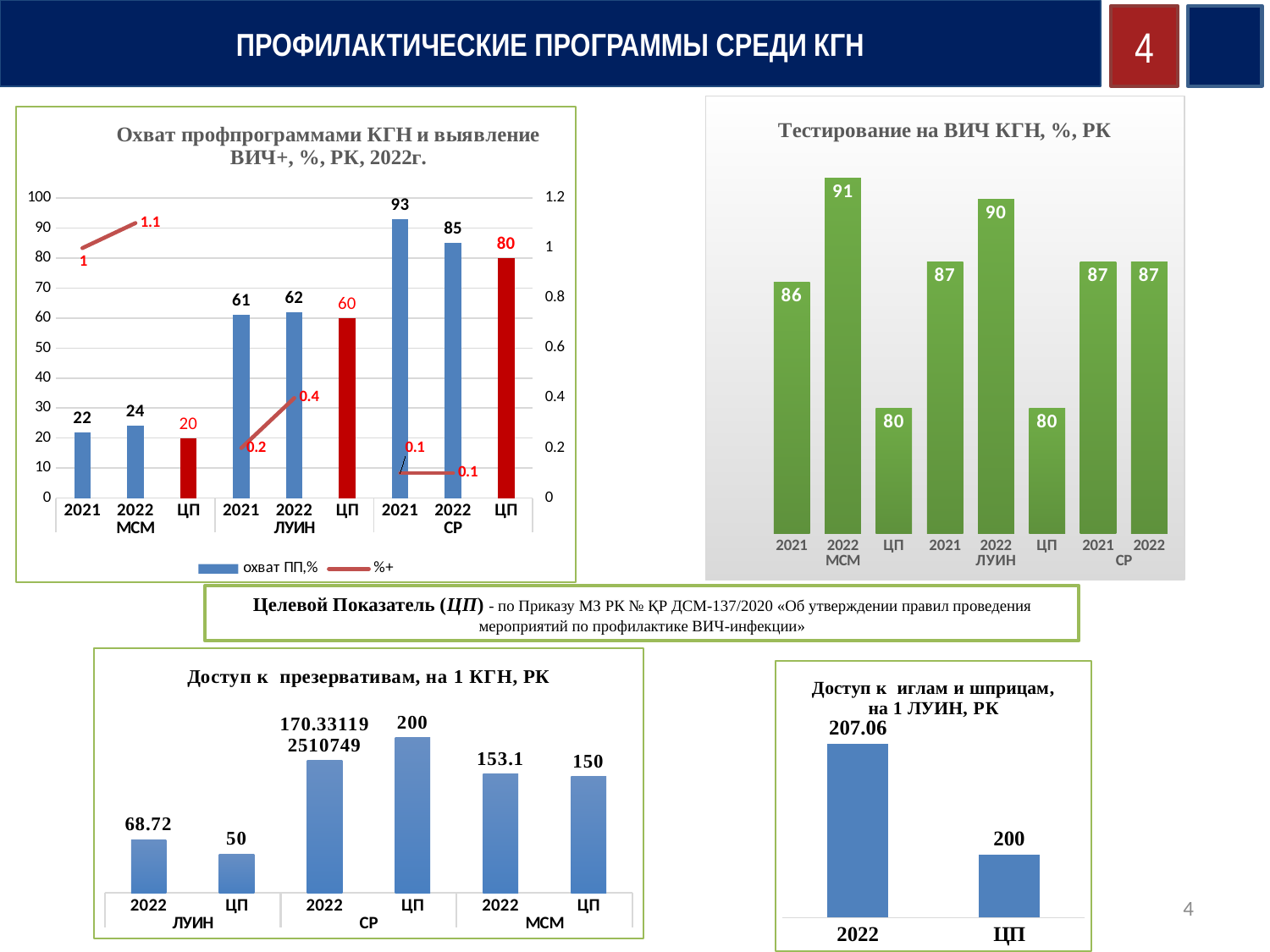
In the chart 'Тестирование на ВИЧ КГН, %, РК', which bar has the highest value? МСМ 2022 In the chart 'Доступ к иглам и шприцам, на 1 ЛУИН, РК', what is the value for 2022? 207.06 In the chart 'Тестирование на ВИЧ КГН, %, РК', what is the difference between ЛУИН 2022 and the ЛУИН ЦП value? 10 In the chart 'Охват профпрограммами КГН и выявление ВИЧ+, %, РК, 2022г.', what is the охват ПП,% value for СР in 2021? 93 How many series does the legend list in the chart 'Охват профпрограммами КГН и выявление ВИЧ+, %, РК, 2022г.'? 2 In the chart 'Охват профпрограммами КГН и выявление ВИЧ+, %, РК, 2022г.', which is larger: the охват ПП,% value for ЛУИН in 2022 or the ЦП value for ЛУИН? ЛУИН 2022 What kind of chart is 'Тестирование на ВИЧ КГН, %, РК'? Bar chart In the chart 'Тестирование на ВИЧ КГН, %, РК', what is the value for МСМ in 2022? 91 In the chart 'Охват профпрограммами КГН и выявление ВИЧ+, %, РК, 2022г.', what is the %+ value for МСМ in 2022? 1.1 In the chart 'Доступ к презервативам, на 1 КГН, РК', what is the value for ЛУИН in 2022? 68.72 In the chart 'Доступ к презервативам, на 1 КГН, РК', which bar has the lowest value? ЛУИН ЦП In the chart 'Доступ к иглам и шприцам, на 1 ЛУИН, РК', what is the difference between the 2022 value and the ЦП value? 7.06